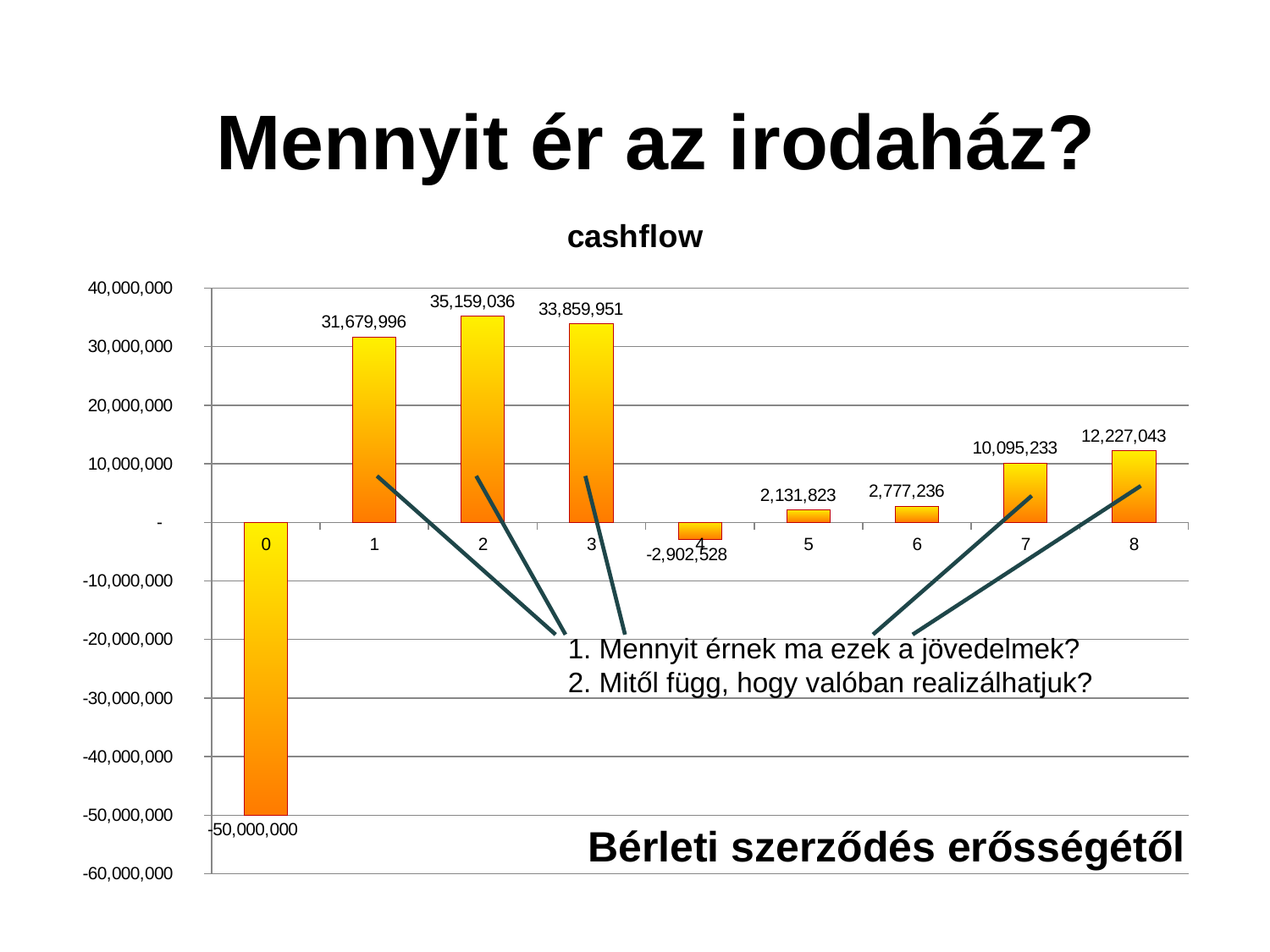
What is the title of the chart? cashflow How many periods (categories) are shown on the x axis of the cashflow chart? 9 Which has a larger cashflow value, period 5 or period 6? 6 Which period has the highest cashflow value? 2 What is the cashflow value for period 0? -50,000,000 What is the cashflow value for period 2? 35,159,036 What is the difference between the cashflow values for period 2 and period 1? 3,479,040 What is the cashflow value for period 4? -2,902,528 What is the cashflow value for period 7? 10,095,233 What is the difference between the cashflow values for period 8 and period 7? 2,131,810 Which period has the lowest cashflow value? 0 What kind of chart is the cashflow chart? bar chart